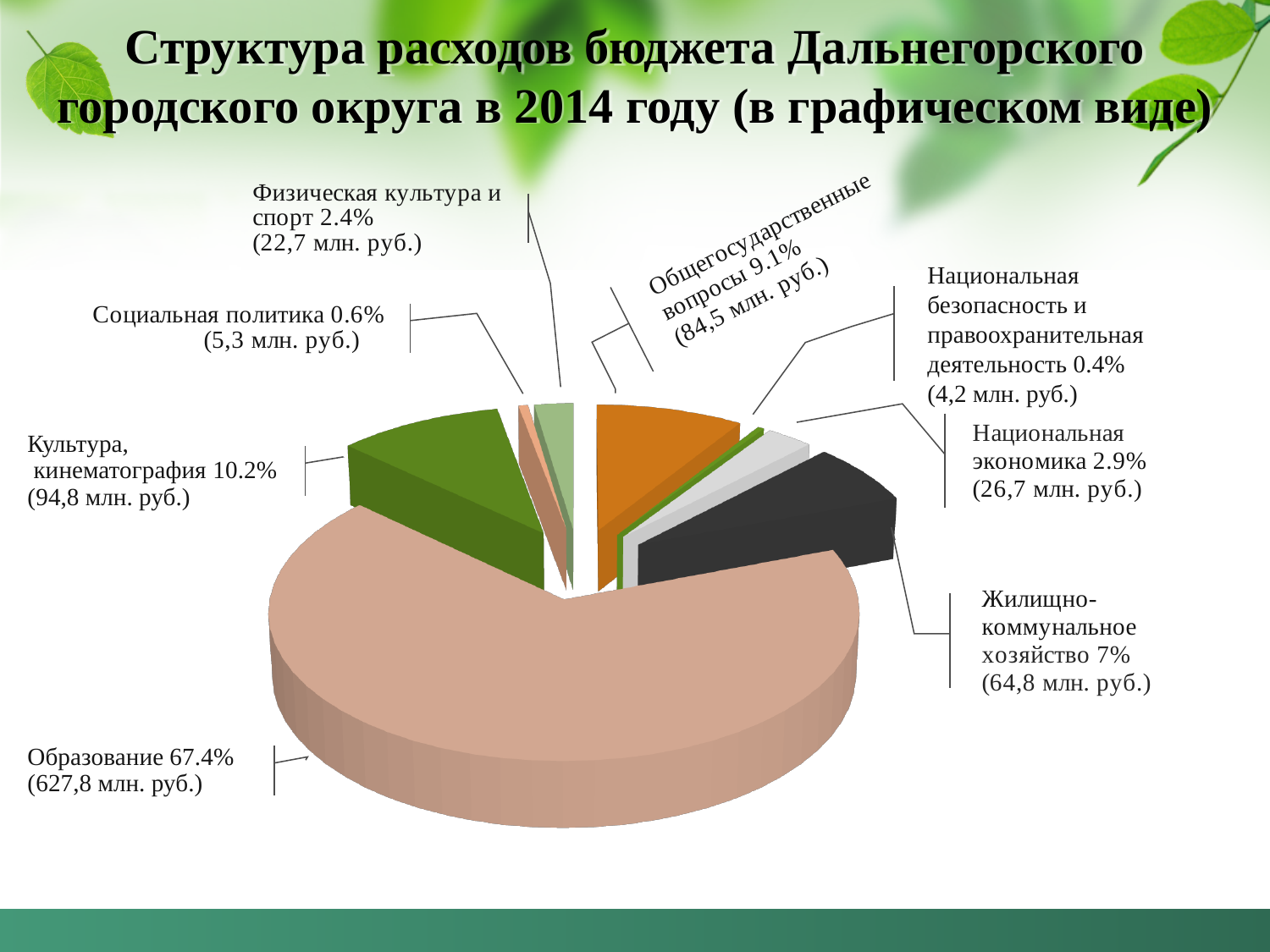
How many categories are shown in the pie chart? 8 What is the amount in млн. руб. for Жилищно-коммунальное хозяйство? 64,8 млн. руб. Which category has the smallest share of the pie? Национальная безопасность и правоохранительная деятельность Which is larger: the share for Культура, кинематография or the share for Общегосударственные вопросы? Культура, кинематография What is the amount in млн. руб. for Культура, кинематография? 94,8 млн. руб. What percentage is shown for Общегосударственные вопросы? 9.1% What type of chart is shown on the slide? Pie chart Which category has the largest share of the pie? Образование What year does the chart title say the budget expenditure structure refers to? 2014 What is the amount in млн. руб. for Национальная экономика? 26,7 млн. руб. What is the difference in percentage points between Физическая культура и спорт and Социальная политика? 1.8 What share of the budget expenditure does Образование account for? 67.4%